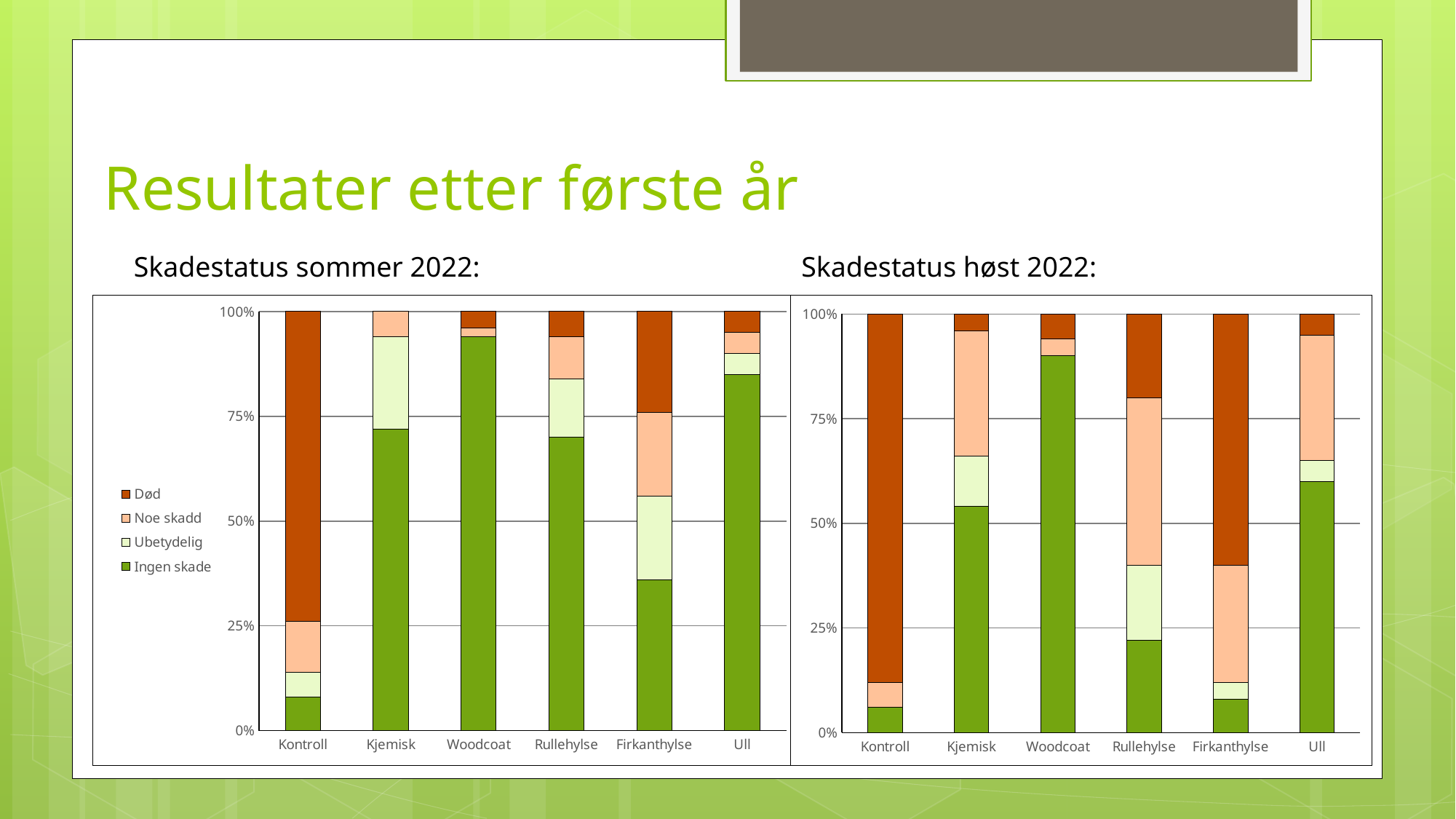
In the 'Skadestatus sommer 2022' chart, which has the larger 'Ingen skade' share, Kjemisk or Firkanthylse? Kjemisk In the 'Skadestatus sommer 2022' chart, is the 'Ingen skade' share for Kjemisk greater or less than 50%? greater What kind of chart is the 'Skadestatus sommer 2022' chart? stacked bar chart In the 'Skadestatus sommer 2022' chart, which category has the smallest 'Ingen skade' share? Kontroll Which legend entry is shown in dark orange-brown in the 'Skadestatus sommer 2022' chart? Død In the 'Skadestatus høst 2022' chart, which category has the largest 'Død' share? Kontroll In the 'Skadestatus høst 2022' chart, is the 'Ingen skade' share for Rullehylse greater or less than 25%? less In the 'Skadestatus høst 2022' chart, which category has the largest 'Ingen skade' share? Woodcoat How many series does the legend of the 'Skadestatus sommer 2022' chart list? 4 How many categories are shown on the x axis of the 'Skadestatus høst 2022' chart? 6 In the 'Skadestatus høst 2022' chart, is the 'Død' share for Firkanthylse greater or less than 50%? greater In the 'Skadestatus sommer 2022' chart, which category has the largest 'Ingen skade' share? Woodcoat